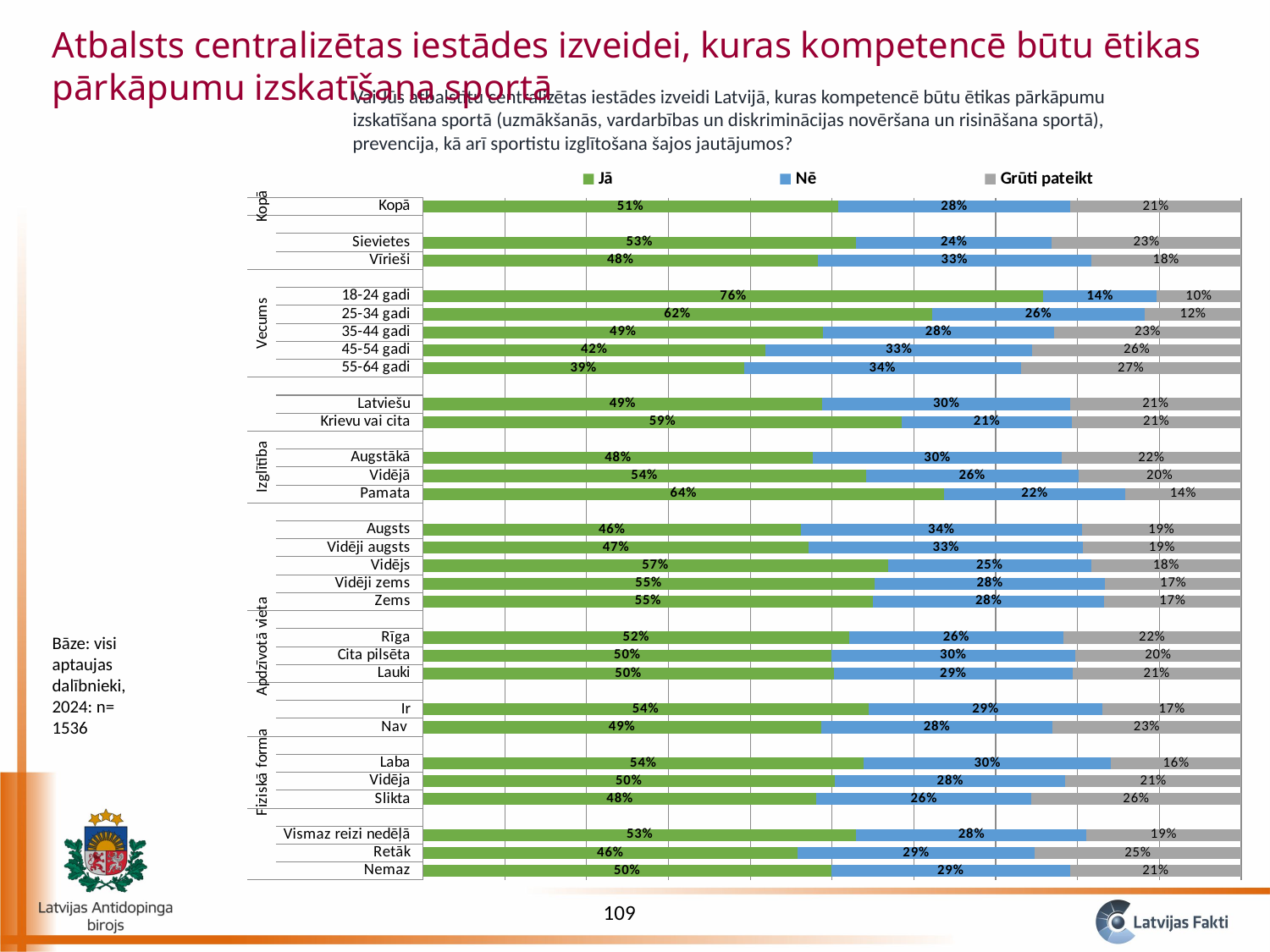
What is the total of the three segments for the Rīga bar? 100% Which series is shown in green? Jā How many series does the legend list? 3 How do the "Jā" values change across the age groups from 18-24 gadi to 55-64 gadi? They fall Which category has the highest "Jā" share? 18-24 gadi Which has a larger "Jā" share, Pamata or Augstākā? Pamata What is the difference between the "Jā" values for Krievu vai cita and Latviešu? 10 percentage points What is the "Grūti pateikt" value for 55-64 gadi? 27% What percentage of all respondents (Kopā) answered "Jā"? 51% What type of chart is shown on the slide? Stacked bar chart What is the "Nē" value for Vīrieši? 33% Which category has the lowest "Jā" share? 55-64 gadi